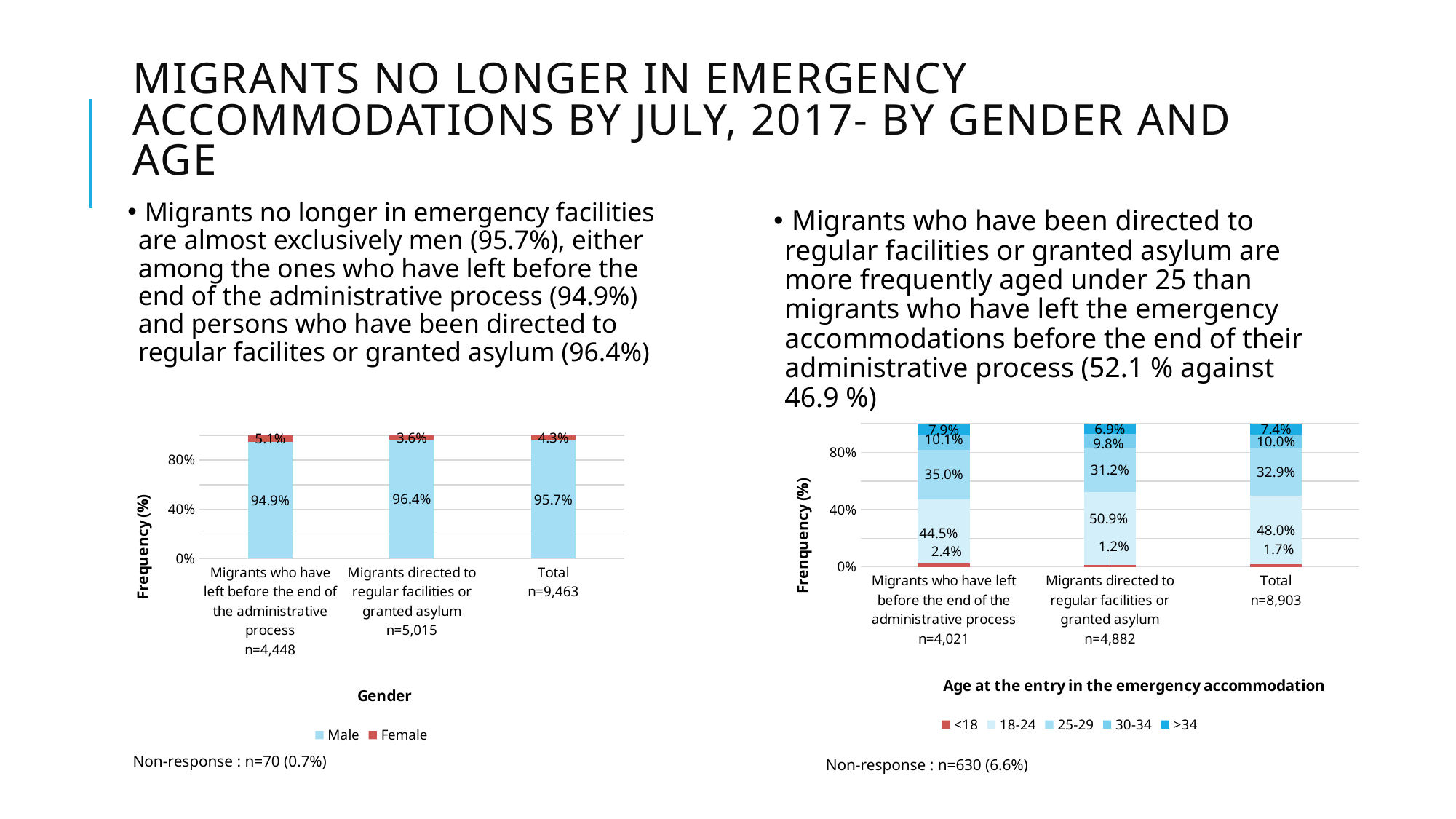
In the Gender chart, what is the difference between the Male percentages for Migrants directed to regular facilities or granted asylum and Migrants who have left before the end of the administrative process? 1.5% In the Gender chart, what is the Female percentage for the Total category? 4.3% In the Age at the entry in the emergency accommodation chart, how many categories are shown on the x axis? 3 In the Gender chart, what is the Male percentage for Migrants directed to regular facilities or granted asylum? 96.4% In the Gender chart, how many series does the legend list? 2 In the Age at the entry in the emergency accommodation chart, is the 18-24 percentage larger for Migrants who have left before the end of the administrative process or for Migrants directed to regular facilities or granted asylum? Migrants directed to regular facilities or granted asylum In the Age at the entry in the emergency accommodation chart, what is the 18-24 percentage for Migrants directed to regular facilities or granted asylum? 50.9% In the Age at the entry in the emergency accommodation chart, how many series does the legend list? 5 In the Gender chart, which category has the highest Female percentage? Migrants who have left before the end of the administrative process In the Age at the entry in the emergency accommodation chart, what is the 25-29 percentage for the Total category? 32.9% In the Age at the entry in the emergency accommodation chart, which category has the lowest <18 percentage? Migrants directed to regular facilities or granted asylum What kind of chart is the Gender chart? Stacked bar chart